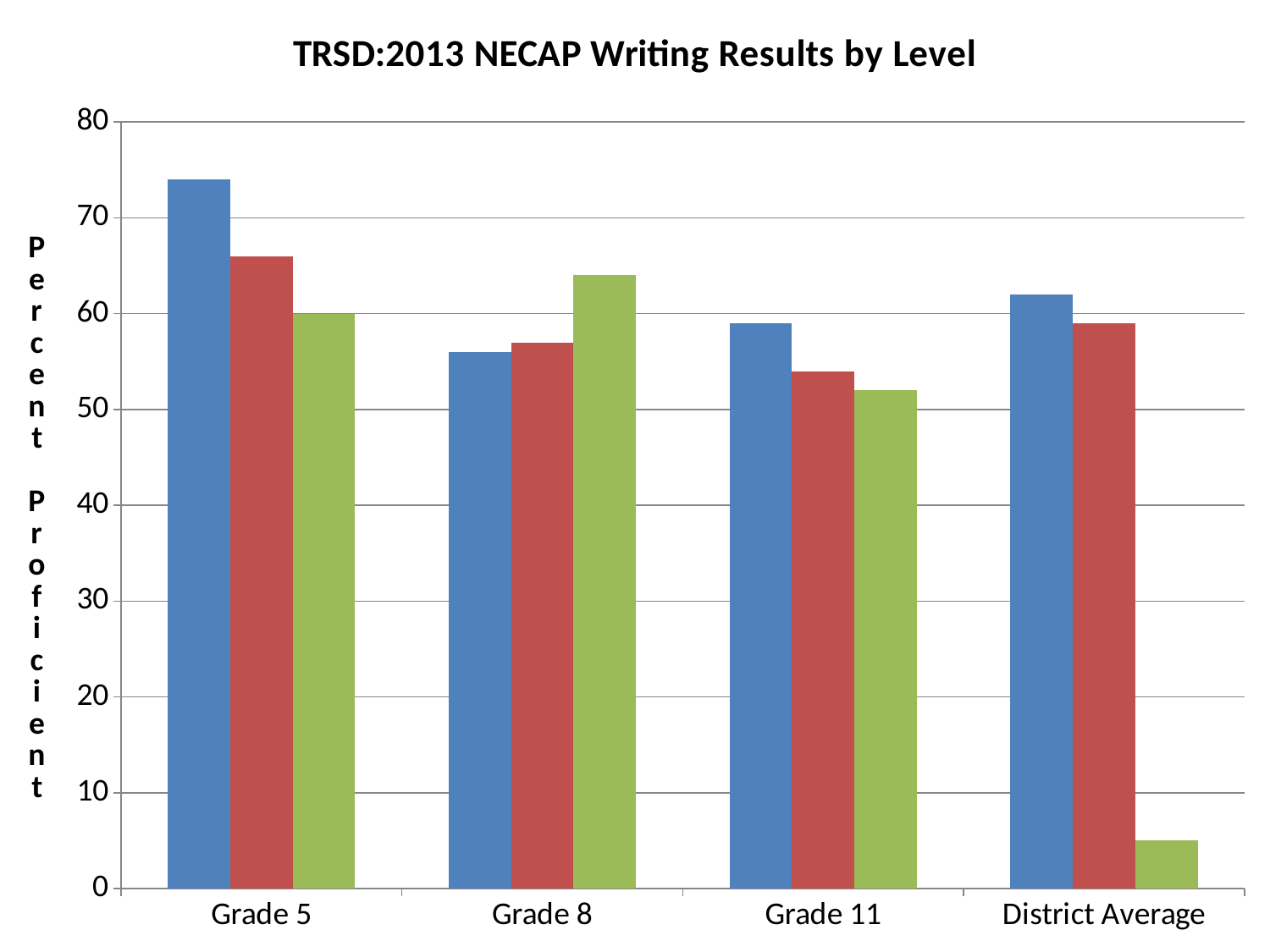
Is the value of the green bar for District Average greater or less than 10? less Which is larger, the blue bar for Grade 5 or the blue bar for Grade 11? Grade 5 How many categories are shown along the x axis? 4 How many bars are shown for each category? 3 Which category has the highest blue bar? Grade 5 Is the value of the blue bar for Grade 5 greater or less than 70? greater Is the value of the red bar for Grade 11 greater or less than 50? greater For Grade 8, which bar is taller, the blue bar or the green bar? green bar What is the title of the chart? TRSD:2013 NECAP Writing Results by Level Which category has the lowest green bar? District Average What is the label on the vertical axis? Percent Proficient What kind of chart is shown on the slide? bar chart